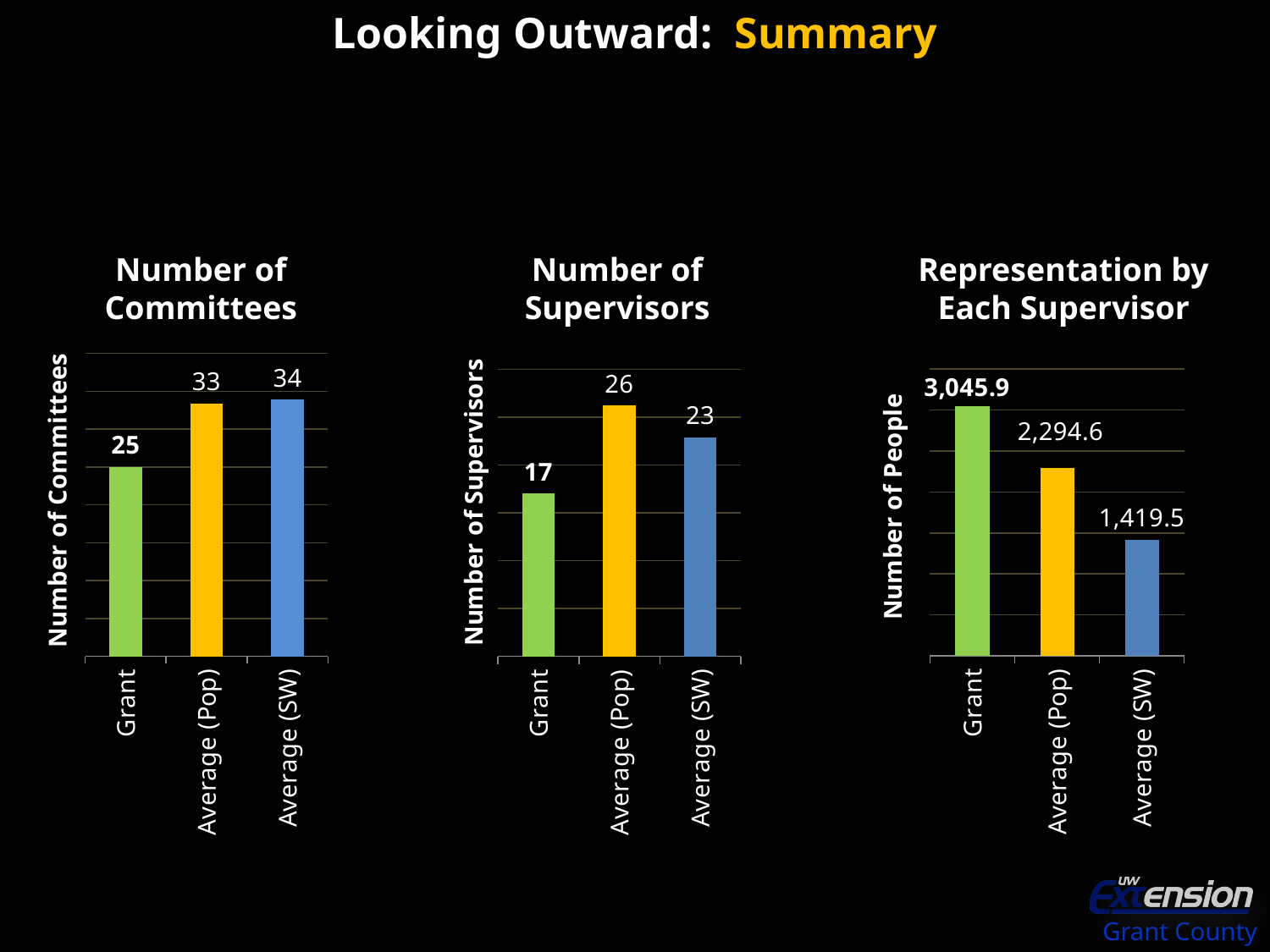
In the 'Number of Supervisors' chart, which is larger, Average (Pop) or Average (SW)? Average (Pop) In the 'Number of Committees' chart, what is the value for Grant? 25 In the 'Number of Supervisors' chart, which category has the lowest value? Grant In the 'Number of Committees' chart, what is the difference between Average (Pop) and Grant? 8 In the 'Representation by Each Supervisor' chart, what is the value for Grant? 3,045.9 In the 'Number of Supervisors' chart, what is the difference between Average (SW) and Grant? 6 In the 'Representation by Each Supervisor' chart, do the values rise or fall from left to right along the x axis? fall In the 'Number of Committees' chart, which category has the highest value? Average (SW) In the 'Representation by Each Supervisor' chart, what is the value for Average (SW)? 1,419.5 What kind of chart is the 'Number of Committees' chart? bar chart In the 'Number of Supervisors' chart, what is the value for Average (Pop)? 26 In the 'Representation by Each Supervisor' chart, which category has the highest value? Grant